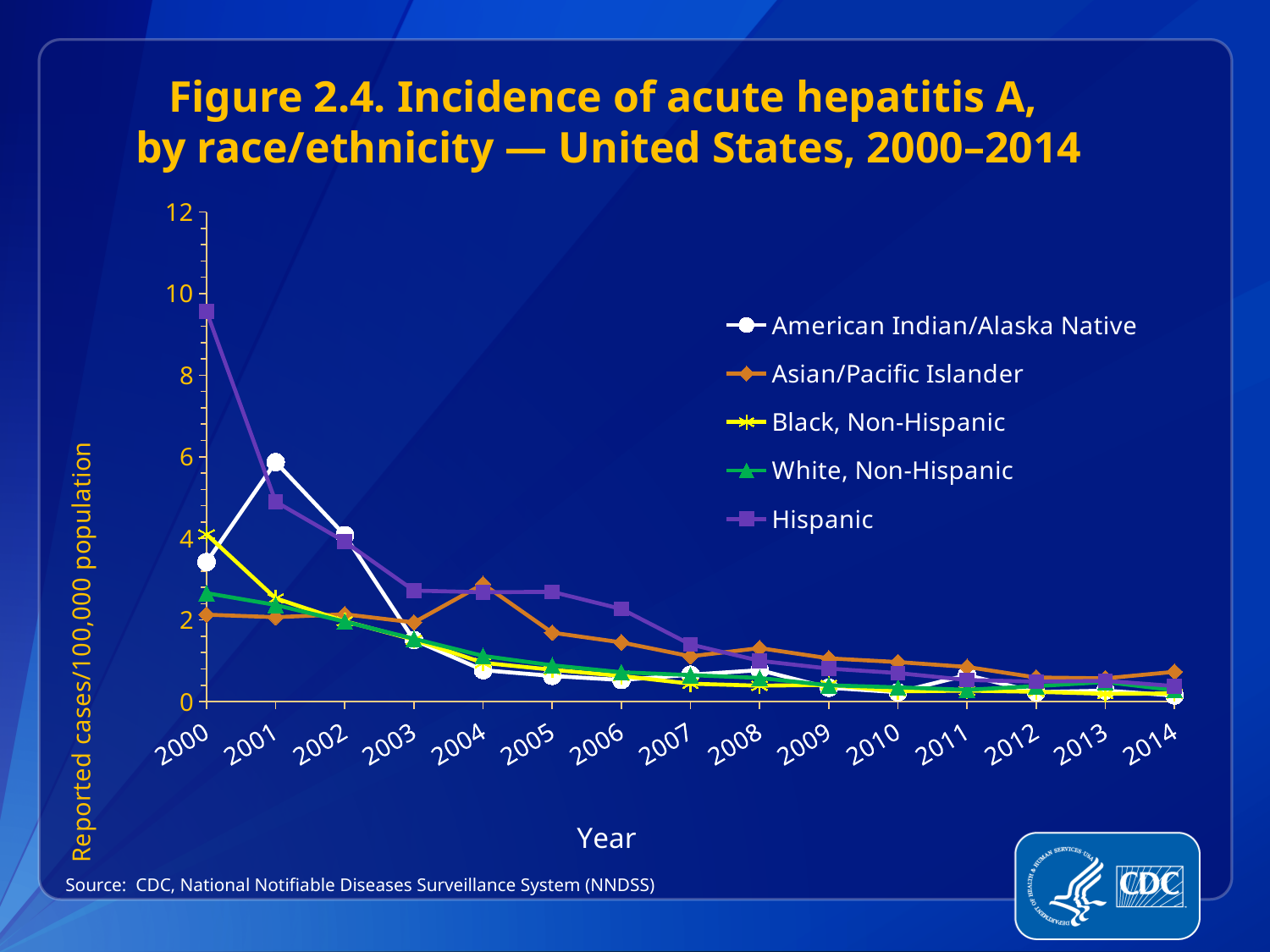
Is the value for American Indian/Alaska Native in 2001 greater or less than 4? greater In 2000, which is larger: the value for Hispanic or the value for American Indian/Alaska Native? Hispanic Which race/ethnicity group had the highest incidence in 2000? Hispanic Does the Hispanic series generally rise or fall from 2000 to 2014? fall Is the value for Hispanic in 2000 greater or less than 8? greater Is the value for Asian/Pacific Islander in 2014 greater or less than 2? less How many series does the legend list? 5 What kind of chart is shown on the slide? line chart How many years are shown along the x axis? 15 Which race/ethnicity group had the highest incidence in 2001? American Indian/Alaska Native What is the label of the y axis? Reported cases/100,000 population In 2002, which is larger: the value for American Indian/Alaska Native or the value for White, Non-Hispanic? American Indian/Alaska Native